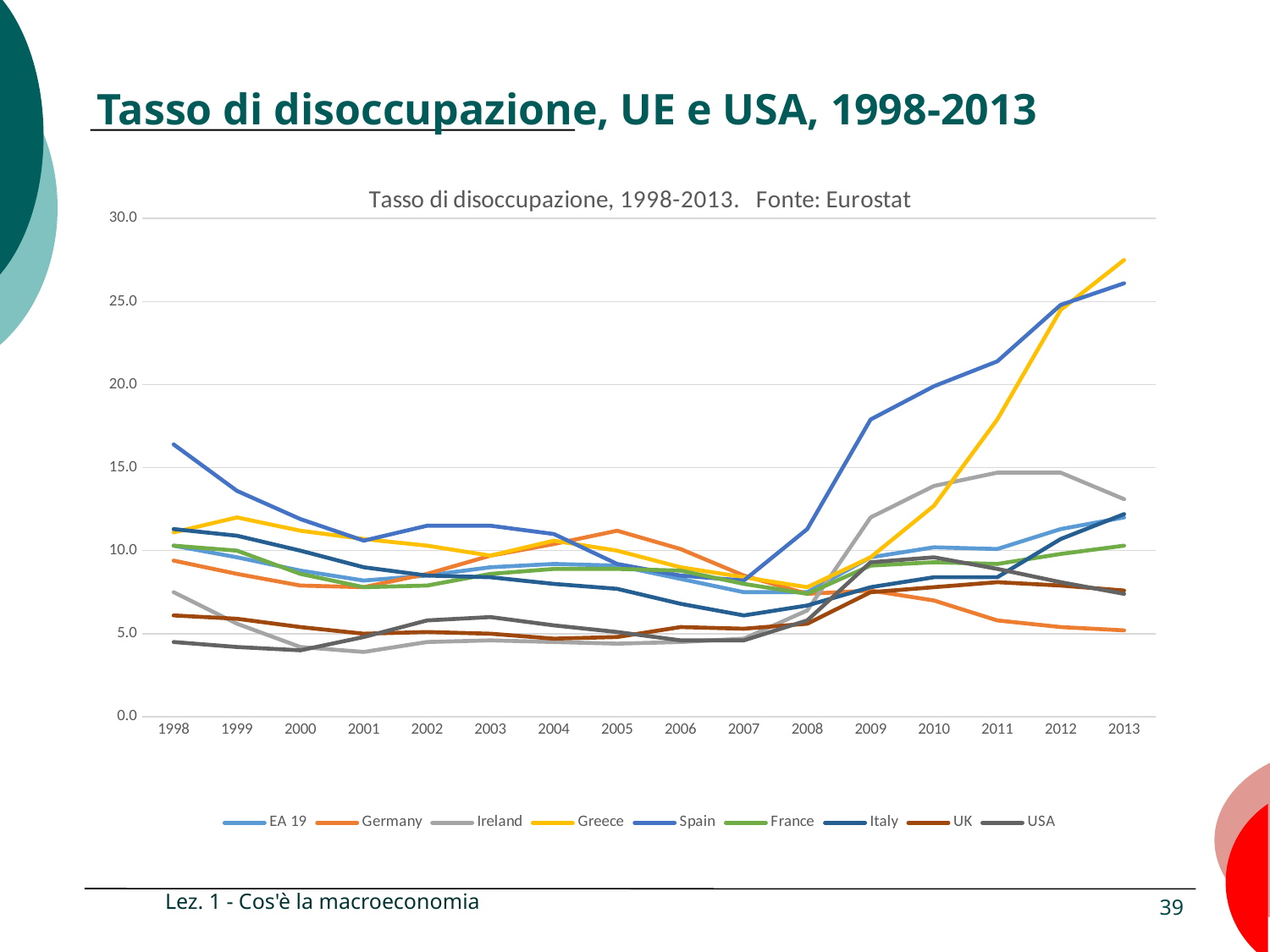
What kind of chart is shown on the slide? line chart Which series has the lowest value in 2013? Germany How many series does the legend list? 9 Which series has the highest value in 1998? Spain Which is larger in 2013, the value for Spain or the value for Germany? Spain Is the value for USA in 2010 greater or less than 5.0? greater Which series has the highest value in 2013? Greece Is the value for Germany in 2013 greater or less than 10.0? less According to the chart title, what is the source of the data? Eurostat Is the value for Spain in 2013 greater or less than 25.0? greater Does the value for Greece rise or fall from 2008 to 2013? rise How many years are shown on the x axis? 16